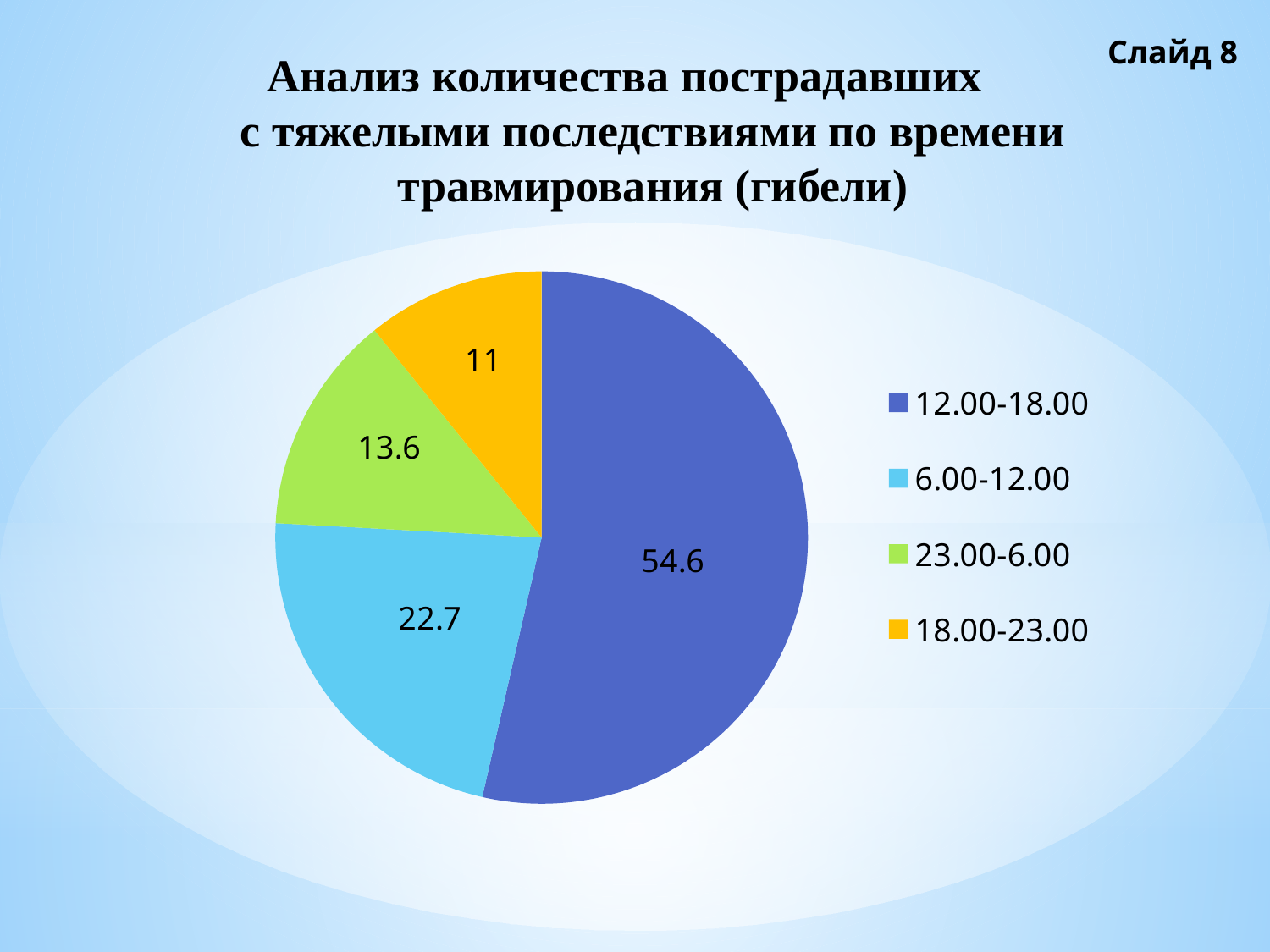
What colour is the 18.00-23.00 slice? yellow Which is larger, the value for 6.00-12.00 or the value for 23.00-6.00? 6.00-12.00 What is the value for the 23.00-6.00 slice? 13.6 Which time period has the smallest slice? 18.00-23.00 What is the value for the 6.00-12.00 slice? 22.7 What is the difference between the values for 23.00-6.00 and 18.00-23.00? 2.6 Which time period has the largest slice? 12.00-18.00 What is the value for the 12.00-18.00 slice? 54.6 What kind of chart is shown on the slide? pie chart What is the value for the 18.00-23.00 slice? 11 How many slices does the pie chart have? 4 What is the difference between the values for 12.00-18.00 and 6.00-12.00? 31.9